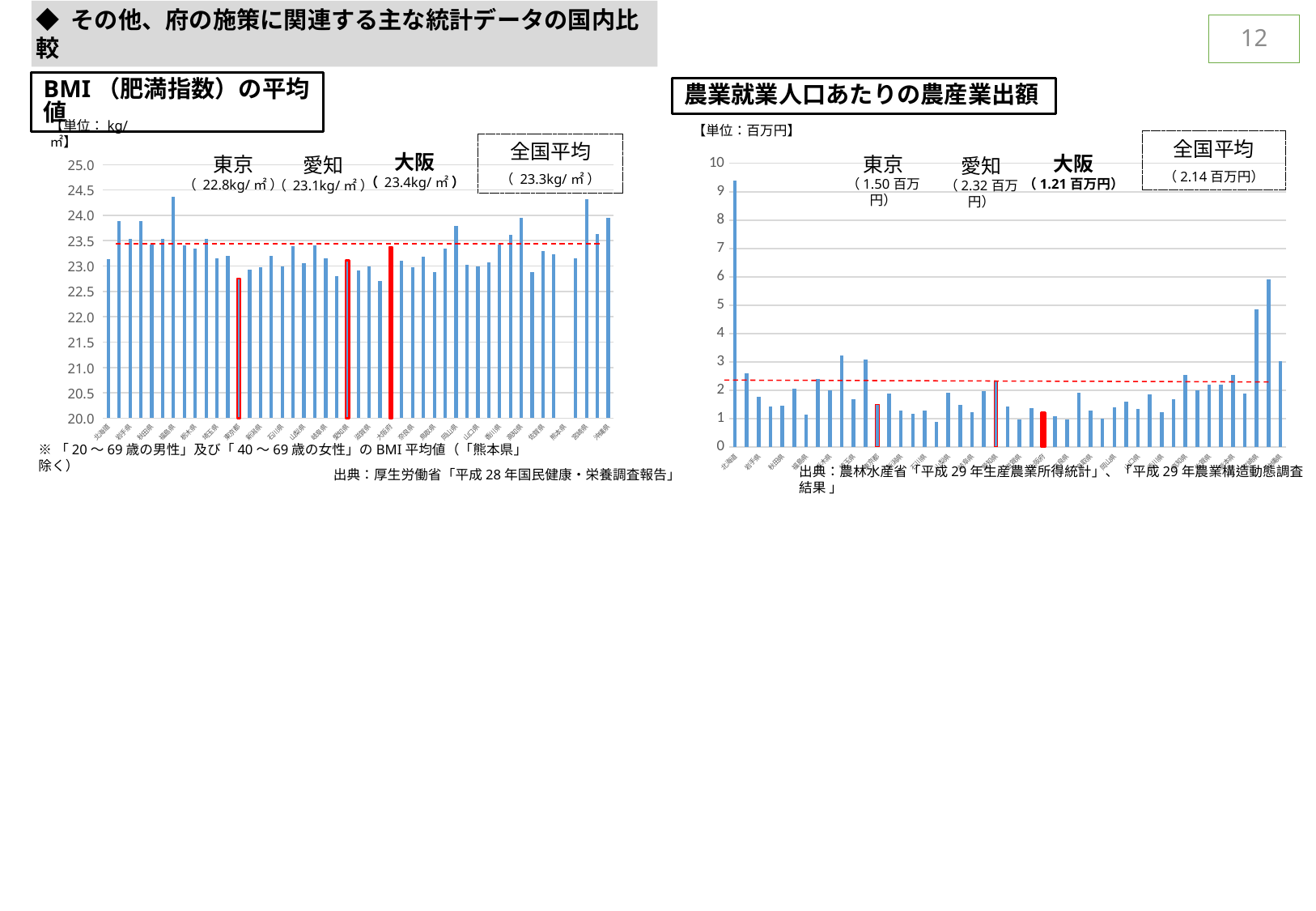
In the left chart (BMI（肥満指数）の平均値), what is the difference between the values for 大阪 and 東京? 0.6kg/㎡ In the left chart (BMI（肥満指数）の平均値), which is larger, the value for 大阪 or the 全国平均? 大阪 In the right chart (農業就業人口あたりの農産業出額), what is the difference between the values for 愛知 and 大阪? 1.11百万円 In the right chart (農業就業人口あたりの農産業出額), which is larger, the value for 東京 or the value for 愛知? 愛知 In the left chart (BMI（肥満指数）の平均値), what is the 全国平均 (national average) shown? 23.3kg/㎡ In the left chart (BMI（肥満指数）の平均値), what is the value for 東京? 22.8kg/㎡ In the right chart (農業就業人口あたりの農産業出額), what is the value for 愛知? 2.32百万円 In the left chart (BMI（肥満指数）の平均値), is the value for 東京 greater or less than 23.0? less In the right chart (農業就業人口あたりの農産業出額), what is the 全国平均 (national average) shown? 2.14百万円 In the left chart (BMI（肥満指数）の平均値), what is the value for 大阪? 23.4kg/㎡ In the right chart (農業就業人口あたりの農産業出額), what is the value for 大阪? 1.21百万円 What kind of chart is the right chart (農業就業人口あたりの農産業出額)? bar chart